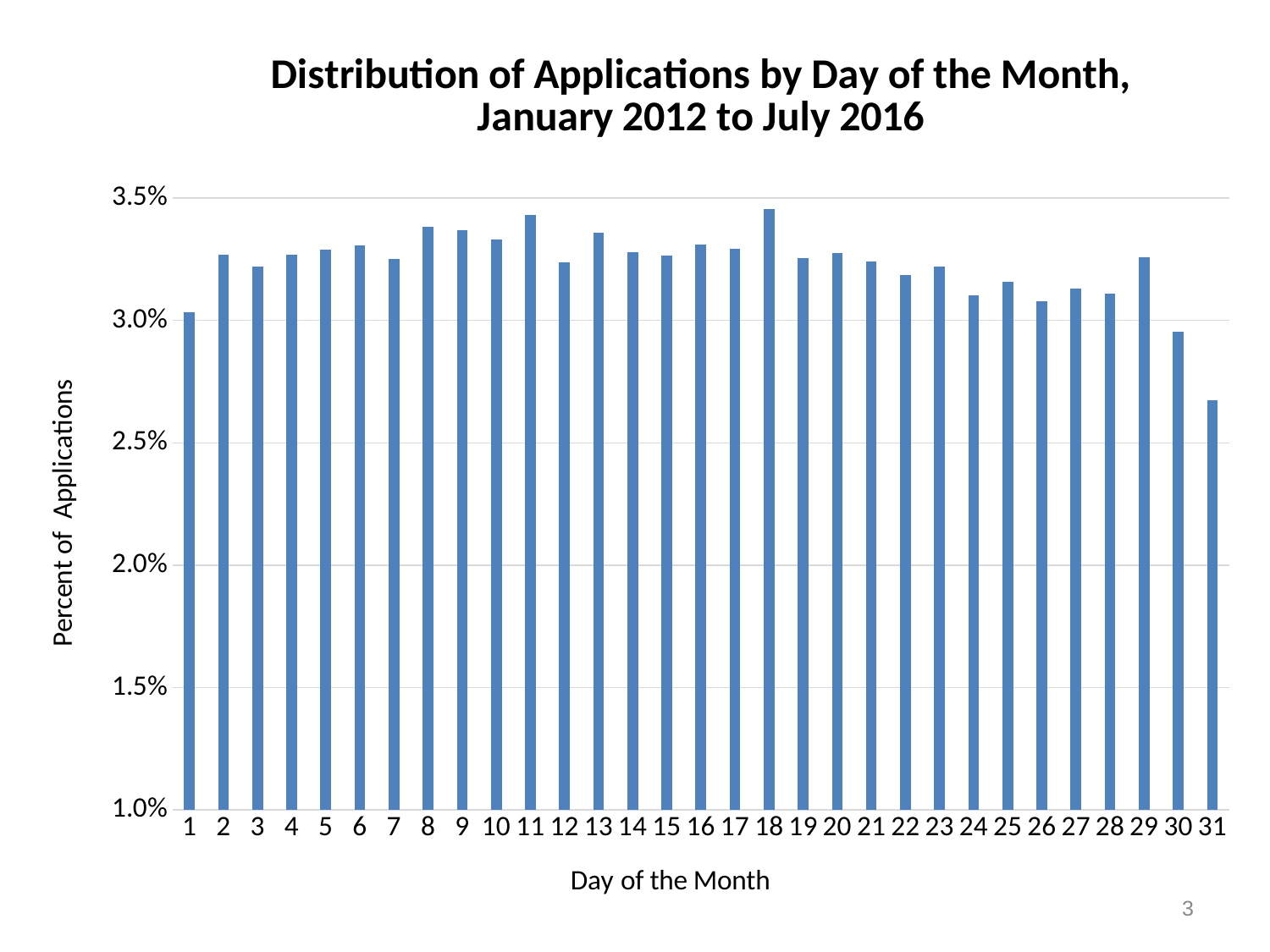
Is the value for day 31 greater or less than 3.0%? less Which has a higher percent of applications, day 1 or day 31? day 1 Which has a higher percent of applications, day 29 or day 30? day 29 Is the value for day 18 greater or less than 3.0%? greater Is the value for day 1 greater or less than 3.5%? less Which day of the month has the lowest percent of applications? 31 Do the values rise or fall from day 29 to day 31? fall How many days of the month are plotted on the chart? 31 What is the label on the vertical axis of the chart? Percent of Applications What kind of chart is shown on the slide? bar chart